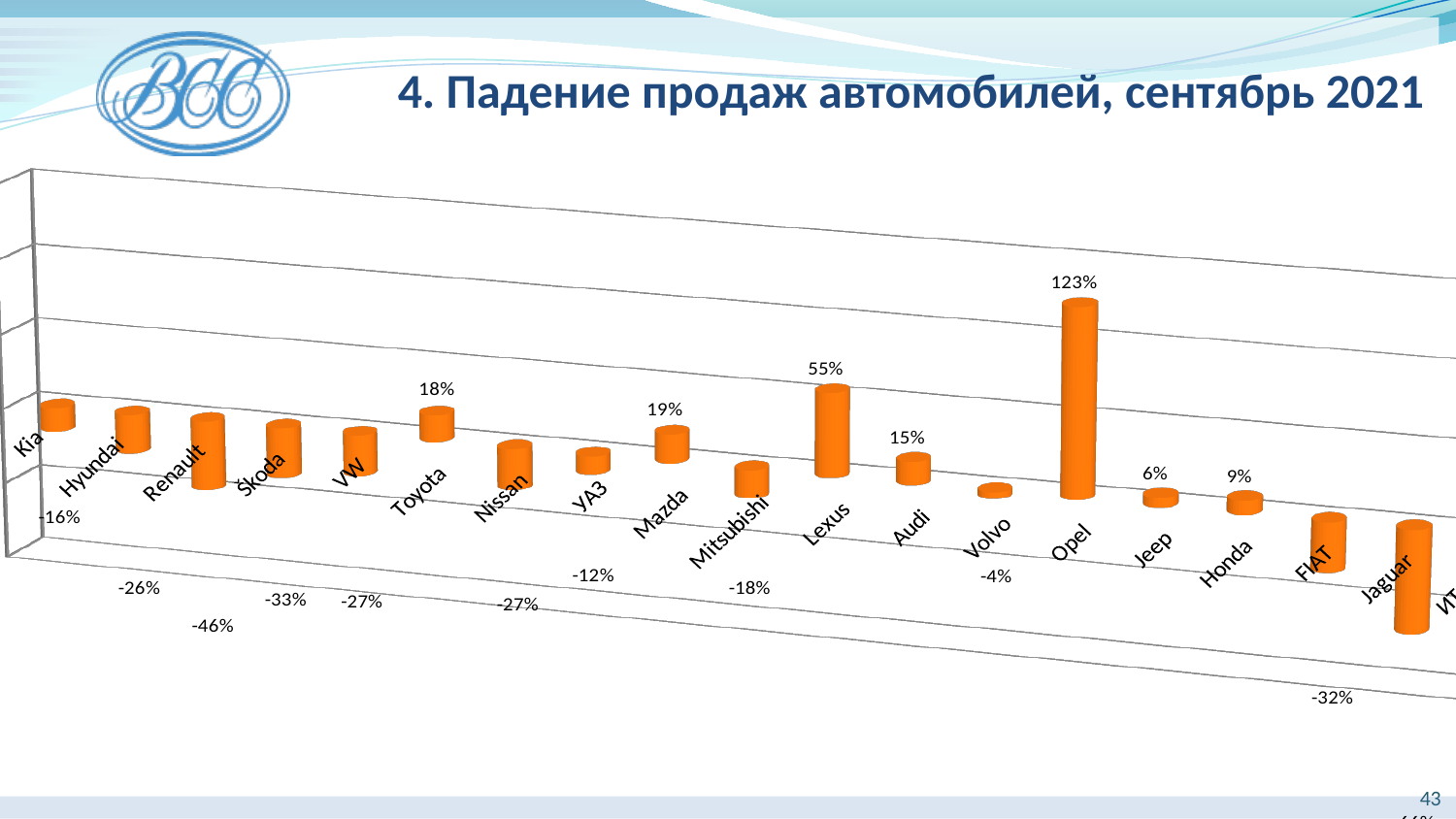
What is the value for Opel? 123% What is the value for Honda? 9% What is the value for Renault? -46% What is the value for Volvo? -4% What is the title of the chart on the slide? 4. Падение продаж автомобилей, сентябрь 2021 What kind of chart is shown on the slide? Bar chart Which is larger, the value for Mazda or the value for Toyota? Mazda What is the value for Lexus? 55% What is the value for Toyota? 18% What is the difference between the values for Opel and Lexus? 68 percentage points Which brand has the highest value on the chart? Opel Which is larger, the value for Lexus or the value for Audi? Lexus